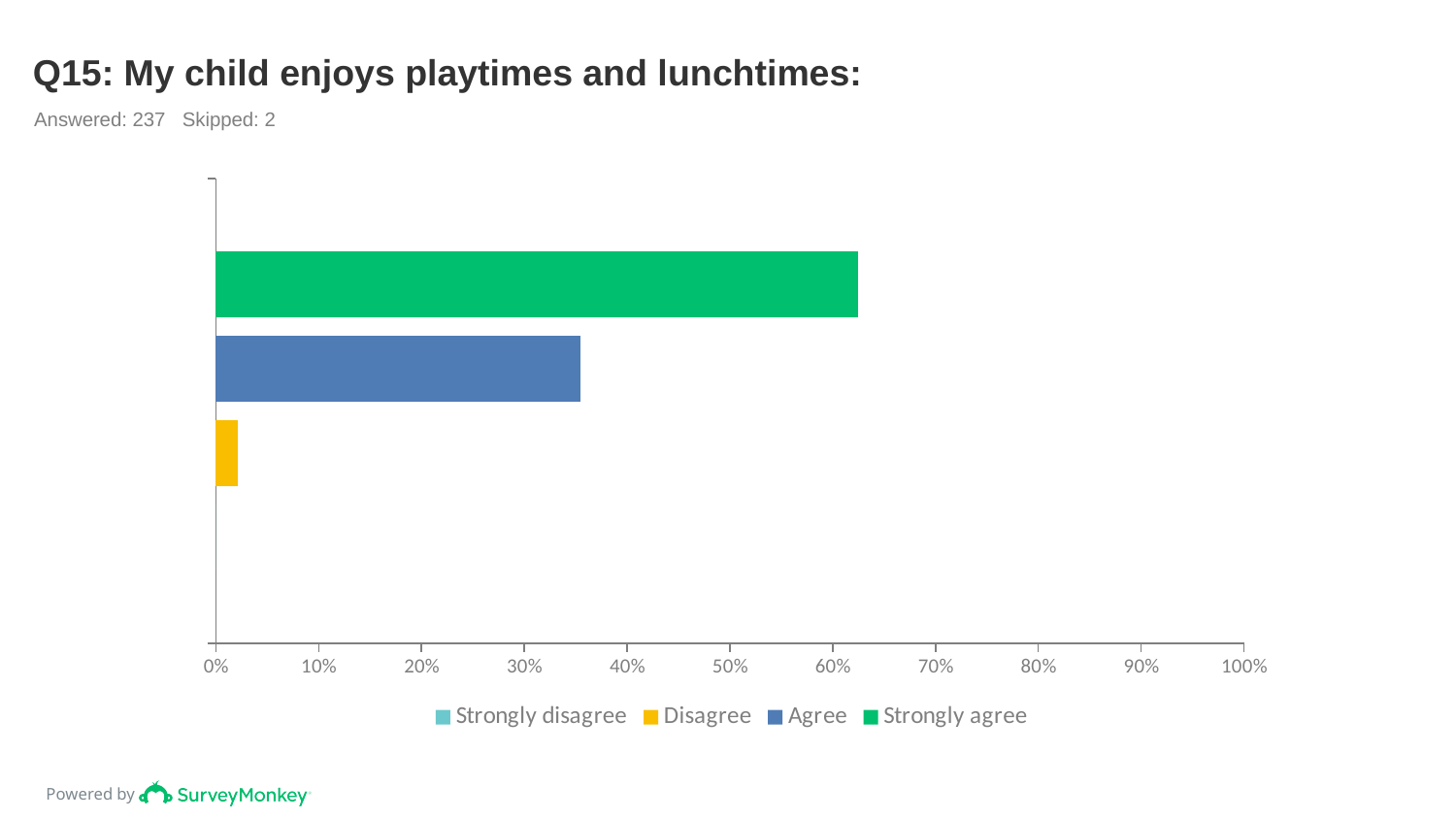
Which response option has the longest bar? Strongly agree Is the value for Disagree greater or less than 10%? less How many series does the legend list? 4 What is the title of the chart? Q15: My child enjoys playtimes and lunchtimes: Is the value for Agree greater or less than 40%? less Is the value for Agree greater or less than 30%? greater Which is larger, the value for Disagree or the value for Agree? Agree What kind of chart is shown on the slide? bar chart What colour is the bar for Strongly agree? green Which of the visible bars is the shortest? Disagree Which is larger, the value for Strongly agree or the value for Agree? Strongly agree